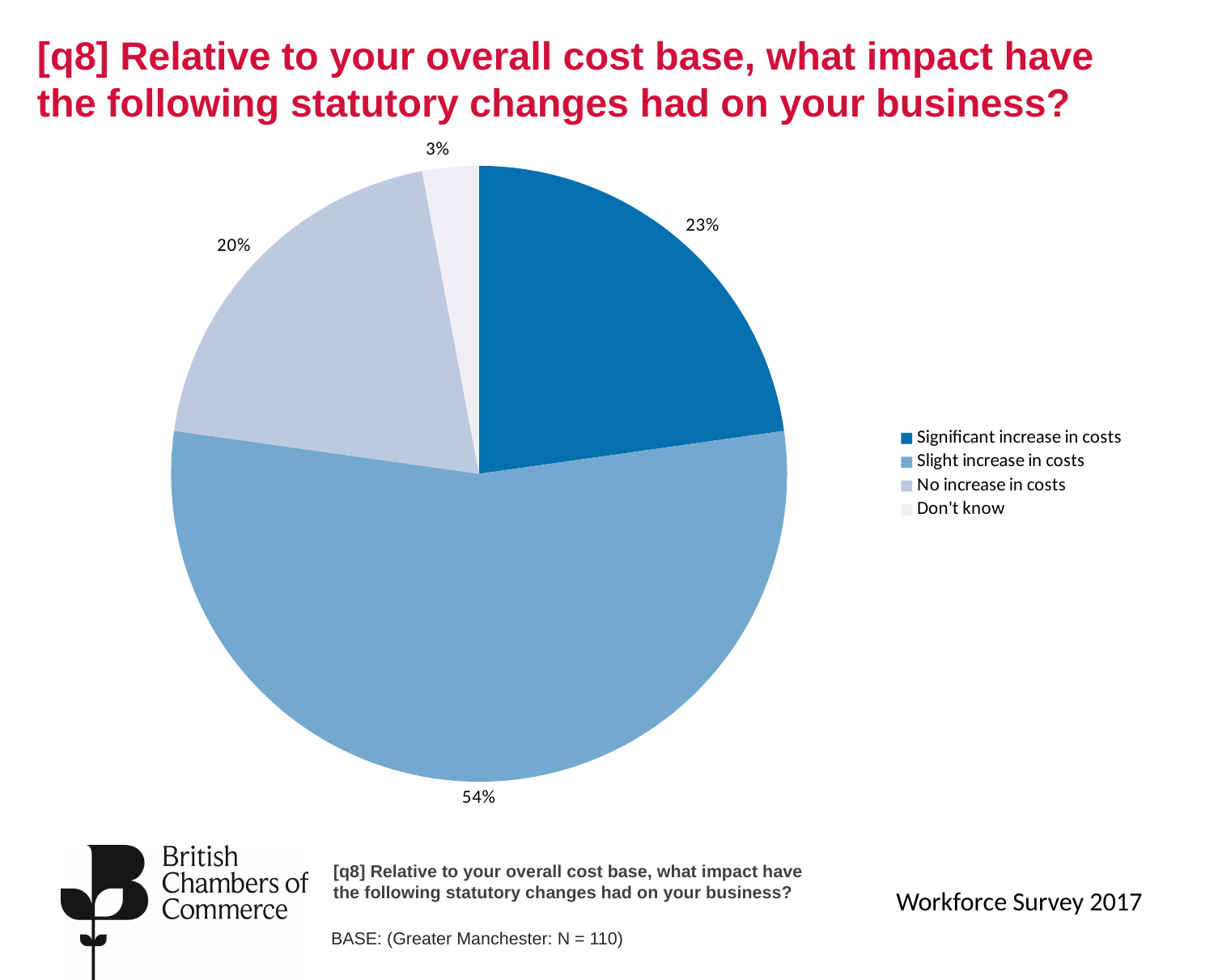
What percentage of respondents reported a significant increase in costs? 23% What is the difference in percentage points between 'Slight increase in costs' and 'Significant increase in costs'? 31 What percentage of respondents reported a slight increase in costs? 54% Which response category has the largest share of the pie? Slight increase in costs What is the base size (N) stated for the Greater Manchester sample? 110 Which response category has the smallest share of the pie? Don't know What type of chart is shown on the slide? Pie chart What percentage of respondents reported no increase in costs? 20% What percentage of respondents answered 'Don't know'? 3% Which is larger: the share for 'Significant increase in costs' or the share for 'No increase in costs'? Significant increase in costs What is the combined percentage of respondents reporting either a significant or a slight increase in costs? 77% How many categories does the legend list? 4